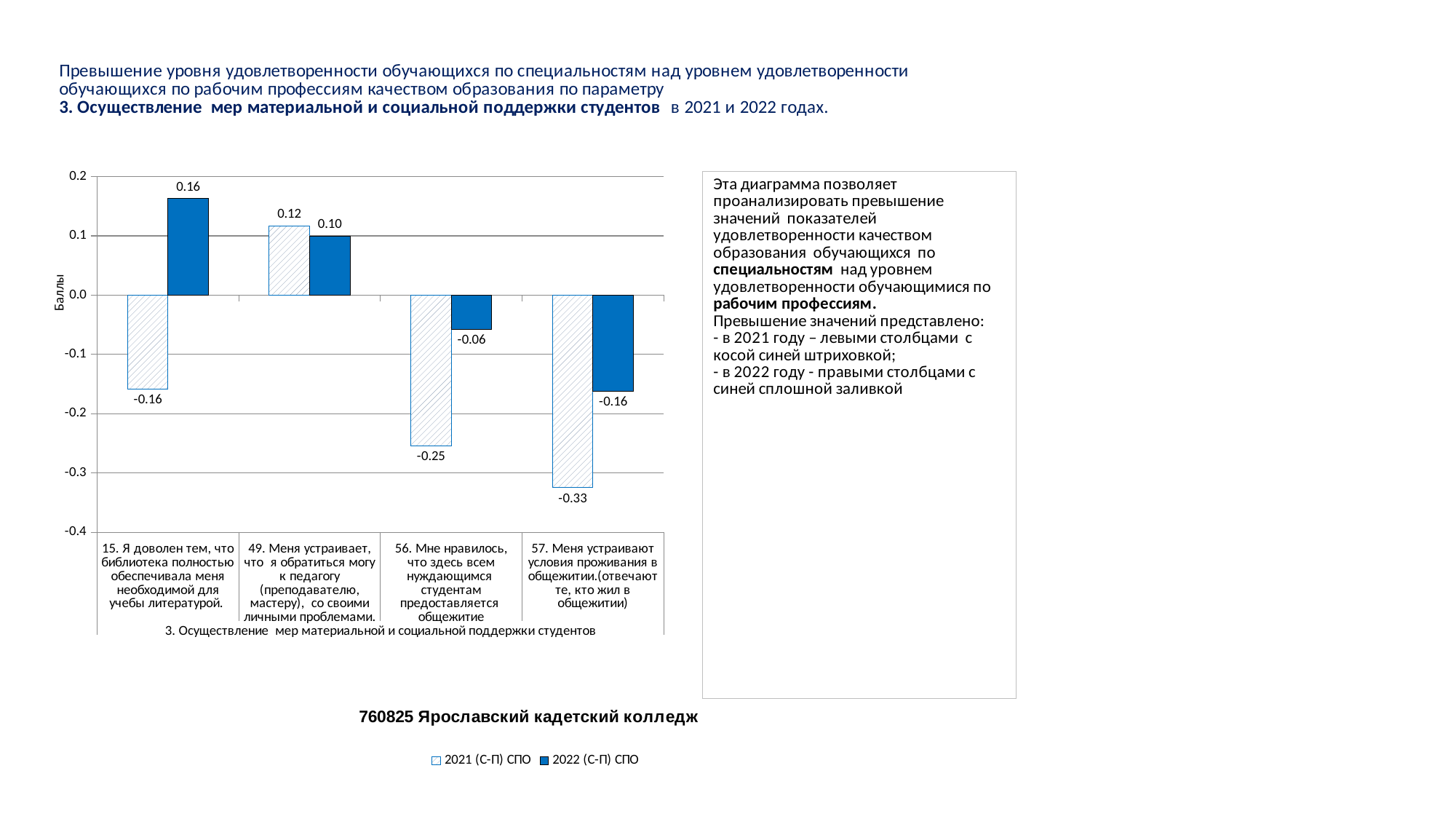
Which category has the lowest 2021 (С-П) СПО value? 57. Меня устраивают условия проживания в общежитии Which category has the highest 2022 (С-П) СПО value? 15. Я доволен тем, что библиотека полностью обеспечивала меня необходимой для учебы литературой What type of chart is shown on the slide? bar chart What is the 2022 (С-П) СПО value for category 56 (dormitory provided to all students in need)? -0.06 What is the difference between the 2021 and 2022 values for category 56? 0.19 What is the label of the y axis of the chart? Баллы What is the 2022 (С-П) СПО value for category 15 (library provided necessary literature)? 0.16 What is the 2021 (С-П) СПО value for category 49 (can turn to a teacher with personal problems)? 0.12 What is the 2021 (С-П) СПО value for category 57 (conditions of living in the dormitory)? -0.33 How many categories are shown on the x axis of the chart? 4 How many series does the legend list? 2 For category 49, which series has the larger value, 2021 (С-П) СПО or 2022 (С-П) СПО? 2021 (С-П) СПО